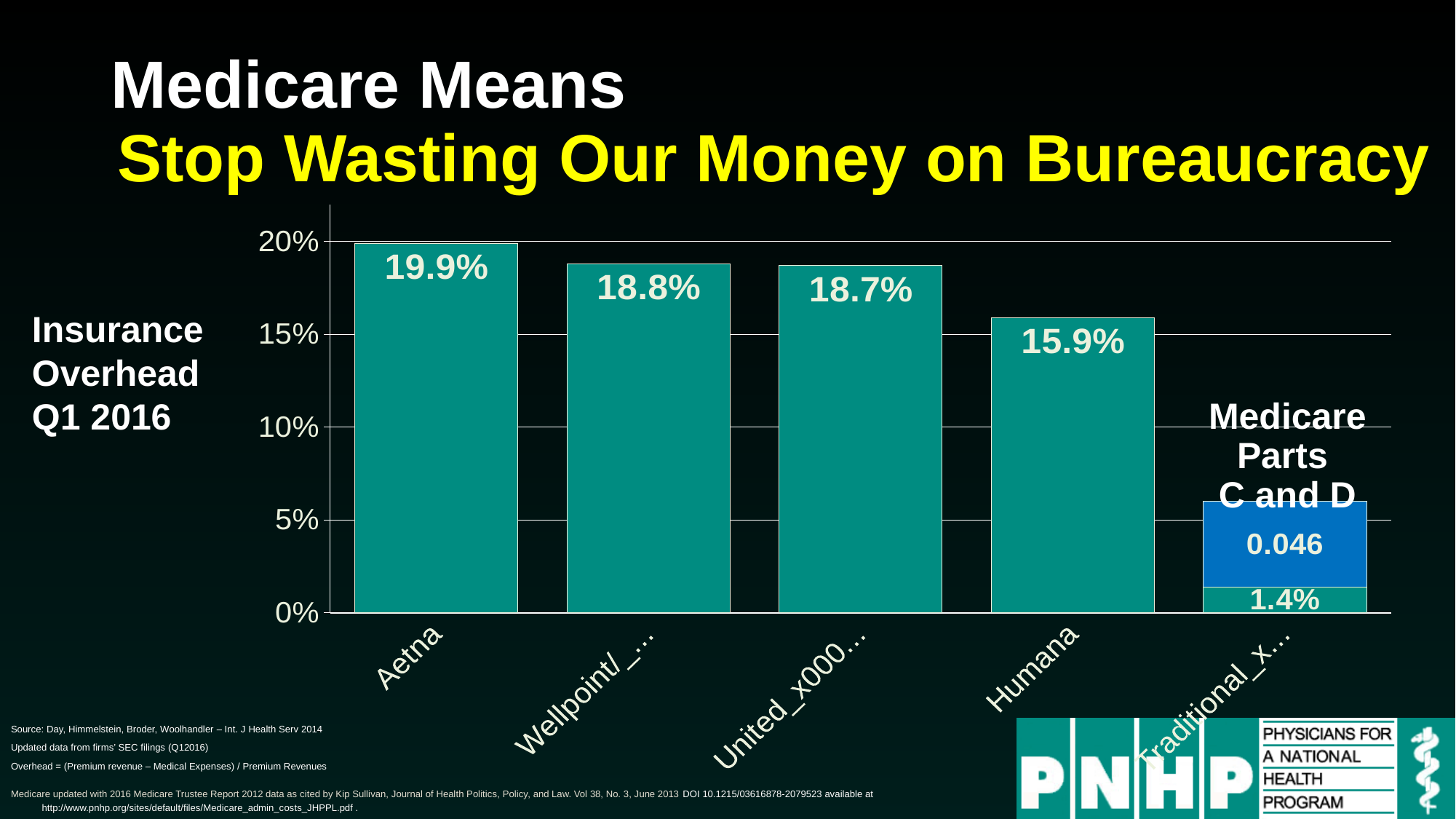
Which category has the highest insurance overhead? Aetna What label appears to the left of the chart describing the data? Insurance Overhead Q1 2016 What is the insurance overhead value shown for Aetna? 19.9% Which is larger, the value for Aetna or the value for Humana? Aetna Do the teal bar values rise or fall from left to right across the chart? fall Is the value for Humana greater or less than 15%? greater What is the insurance overhead value shown for Humana? 15.9% What is the difference between the values for Aetna and Humana? 4.0% What value is printed on the blue segment labelled Medicare Parts C and D? 0.046 What kind of chart is shown on the slide? bar chart How many categories are shown on the x axis of the chart? 5 What value is printed on the Wellpoint bar? 18.8%